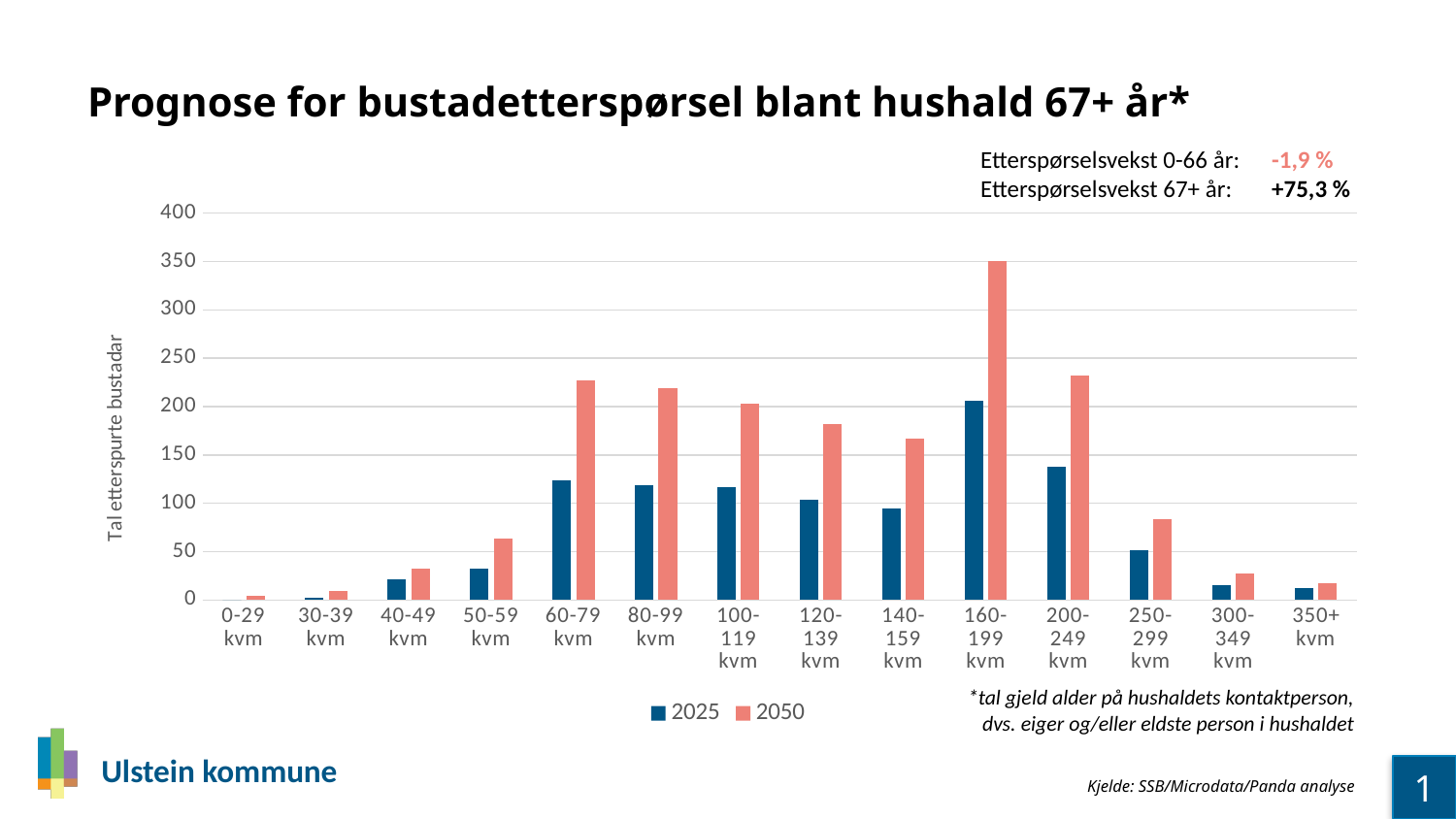
For the 160-199 kvm category, which series has the larger value, 2025 or 2050? 2050 Is the 2025 value for 40-49 kvm greater or less than 50? less How many series does the legend list? 2 Is the 2050 value for 160-199 kvm greater or less than 300? greater For the 2025 series, which is larger: 200-249 kvm or 120-139 kvm? 200-249 kvm What is the label on the y axis of the chart? Tal etterspurte bustadar Which category has the highest value for the 2050 series? 160-199 kvm How many size categories are shown on the x axis? 14 Is the 2050 value for 60-79 kvm greater or less than 200? greater Which category has the highest value for the 2025 series? 160-199 kvm Which category has the lowest value for the 2025 series? 0-29 kvm What kind of chart is shown on the slide? bar chart